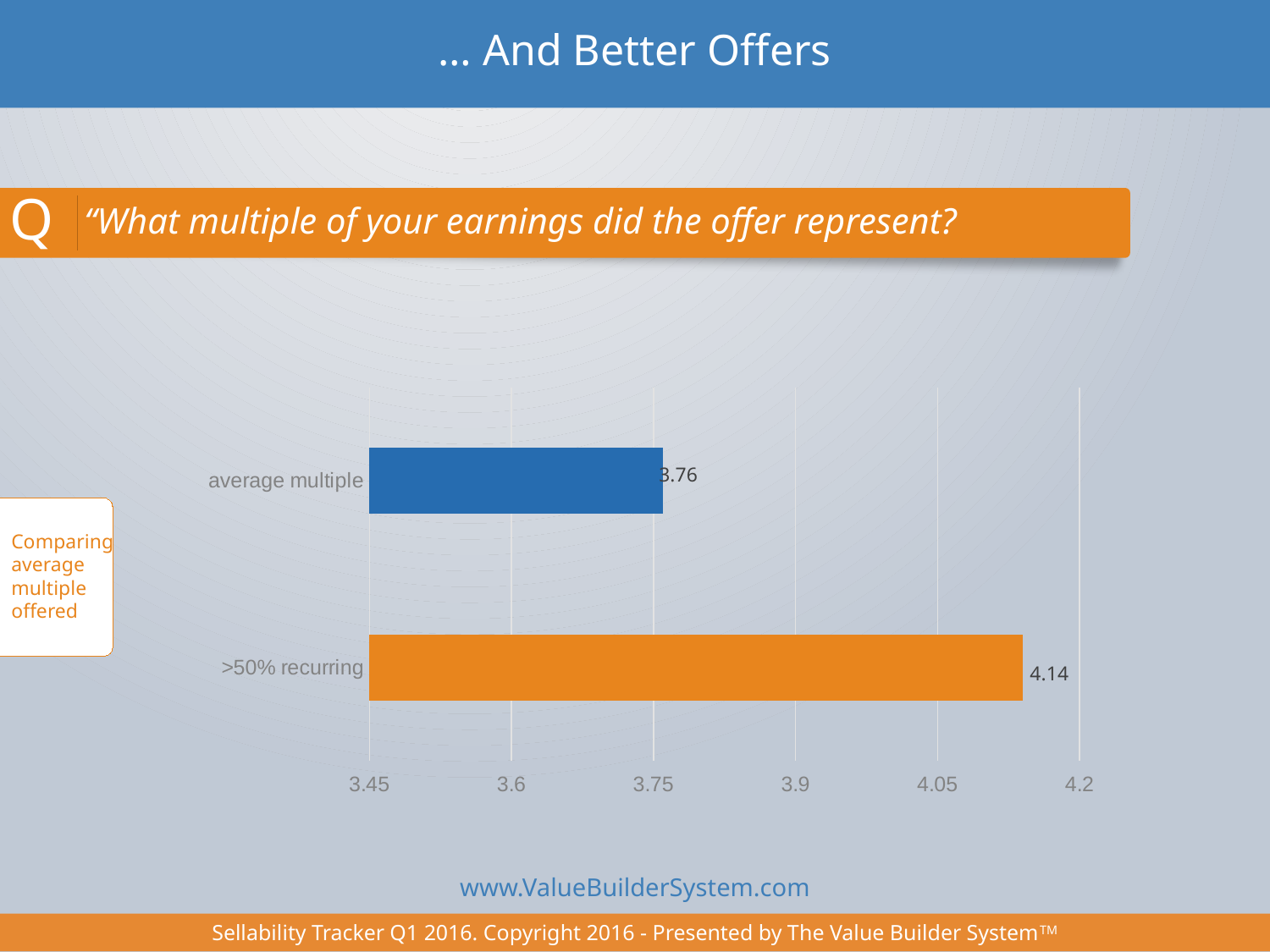
Which category has the highest value? >50% recurring Which category has the lowest value? average multiple What is the difference between the value for ">50% recurring" and the value for "average multiple"? 0.38 Is the value for ">50% recurring" greater or less than 4.05? greater Which is larger, the value for "average multiple" or the value for ">50% recurring"? >50% recurring What is the value for ">50% recurring"? 4.14 What kind of chart is shown on the slide? bar chart How many categories are shown in the chart? 2 What is the highest value shown on the x axis? 4.2 Is the value for "average multiple" greater or less than 3.9? less What is the value for "average multiple"? 3.76 What colour is the bar for ">50% recurring"? orange